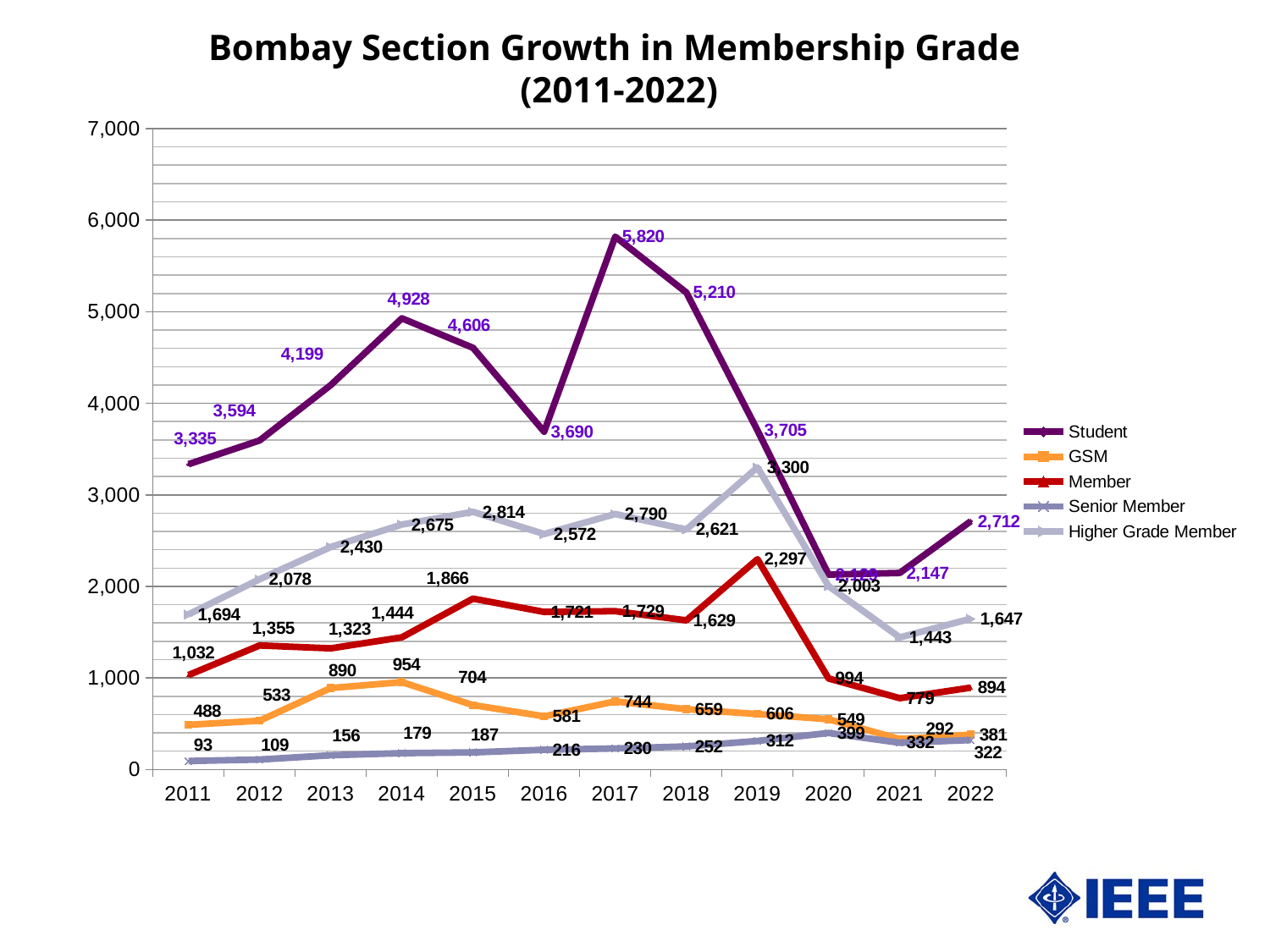
What is the title of the chart? Bombay Section Growth in Membership Grade (2011-2022) What was the Higher Grade Member value in 2019? 3,300 Did the Senior Member series generally rise or fall from 2011 to 2020? rise What is the difference between the Member values in 2019 and 2020? 1,303 What was the Senior Member value in 2011? 93 Which was larger in 2014, GSM or Senior Member? GSM In which year was the Student membership highest? 2017 How many years are shown on the x axis? 12 What was the Student membership in 2017? 5,820 How many series does the legend list? 5 What type of chart is shown on the slide? line chart In which year was the Member series lowest? 2021